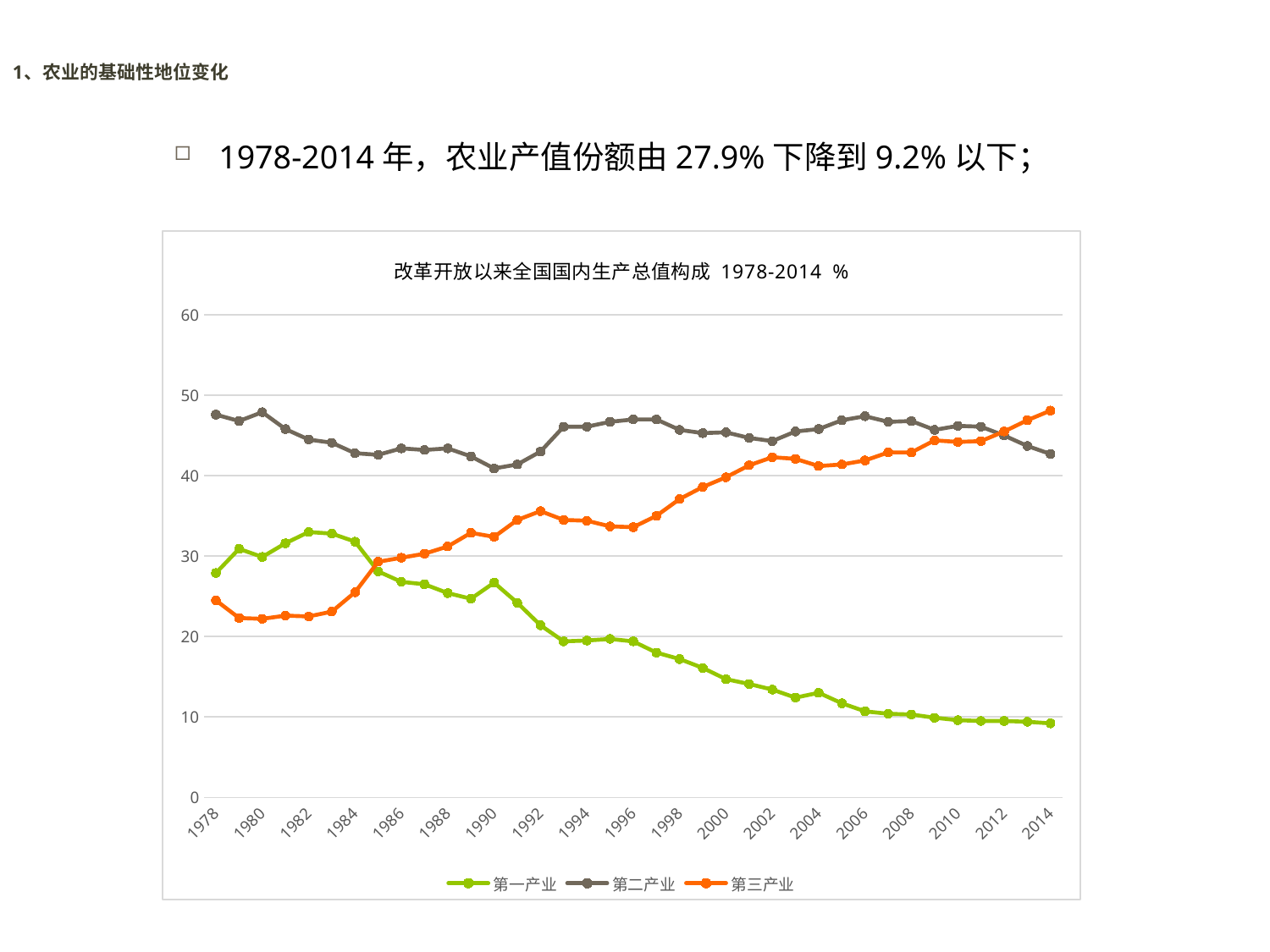
Does the value for 第一产业 rise or fall from 1978 to 2014? fall Which series has the highest value in 1978? 第二产业 Is the value for 第二产业 in 1990 greater or less than 40? greater What is the title of the chart? 改革开放以来全国国内生产总值构成 1978-2014 % Which series has the highest value in 2014? 第三产业 What kind of chart is shown on the slide? line chart Is the value for 第一产业 in 2014 greater or less than 10? less How many series does the chart legend list? 3 In 2000, which is larger: the value for 第二产业 or the value for 第三产业? 第二产业 Which series has the lowest value in 1978? 第三产业 Does the value for 第三产业 rise or fall from 1978 to 2014? rise Which series is drawn in orange? 第三产业